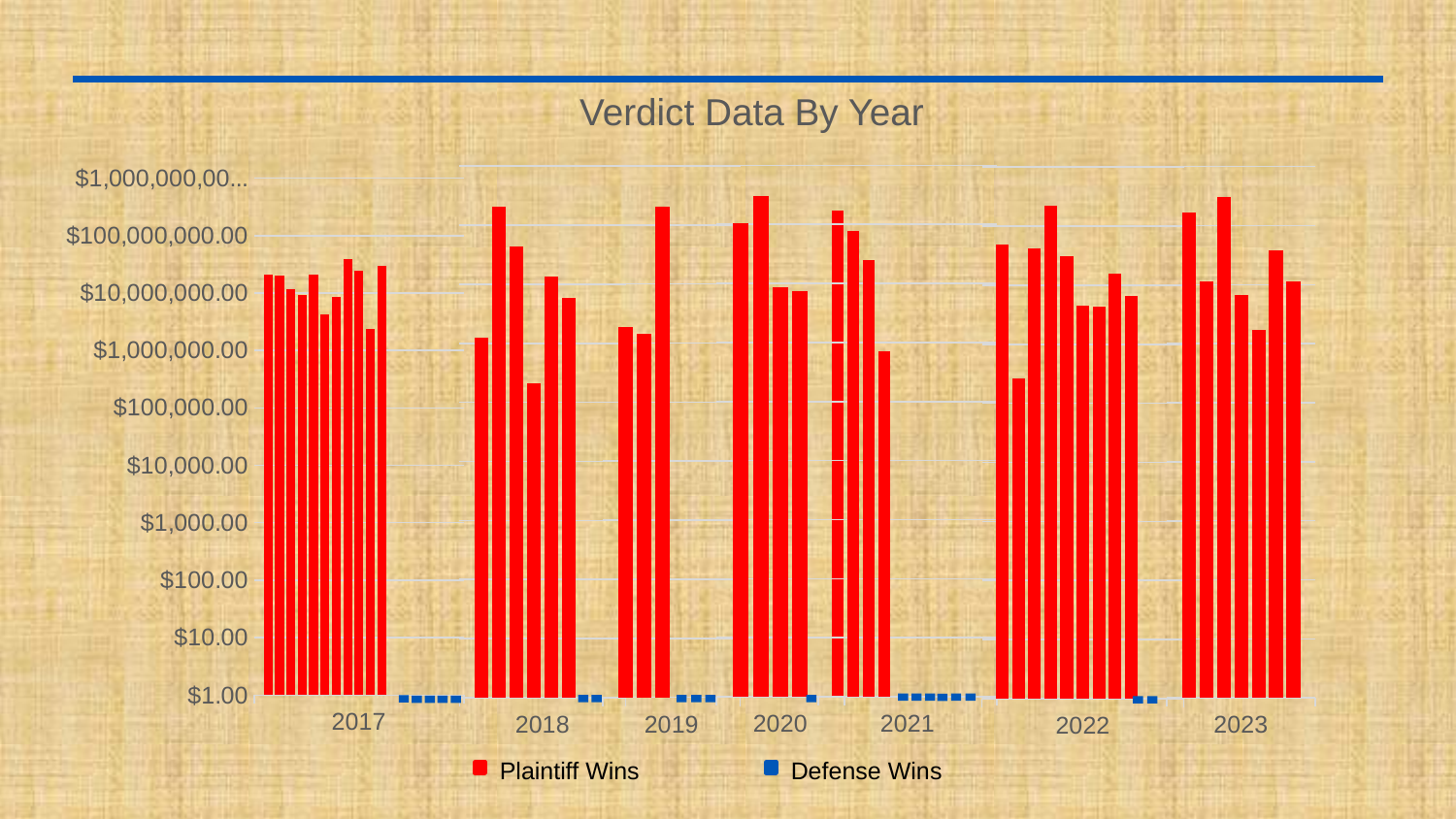
What is the title of the chart? Verdict Data By Year How many series does the legend list? 2 Is the tallest Plaintiff Wins bar in 2023 greater or less than $100,000,000.00? greater Is the tallest Plaintiff Wins bar in 2018 greater or less than $100,000,000.00? greater What colour are the Plaintiff Wins bars? red Is the tallest Plaintiff Wins bar in 2017 greater or less than $100,000,000.00? less Which year has the larger tallest Plaintiff Wins bar, 2017 or 2019? 2019 What kind of chart is shown on the slide? bar chart Which year shows no Defense Wins markers? 2023 How many years are shown along the x axis? 7